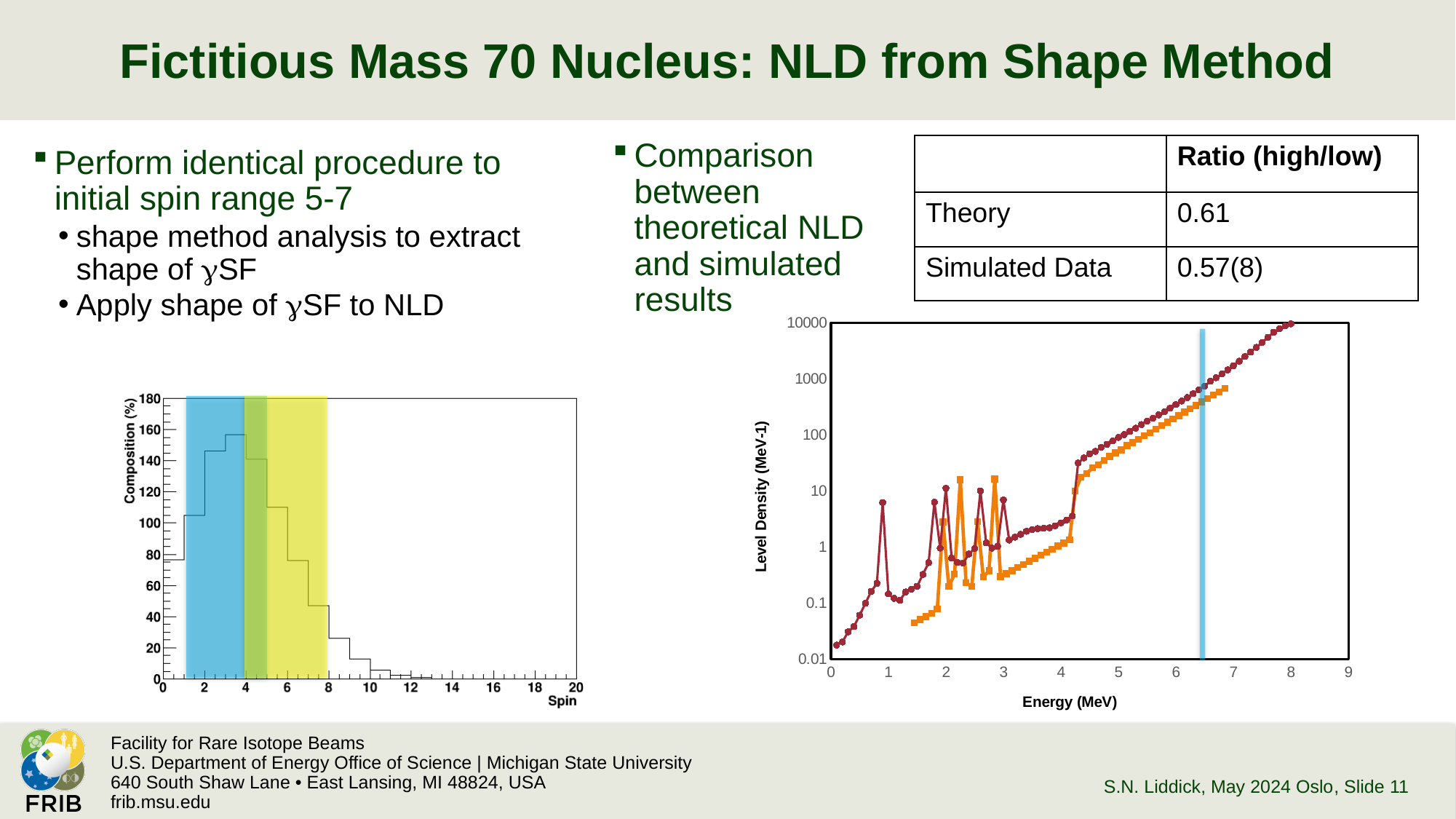
How many data series are plotted in the chart on the right? 2 What is the y-axis label of the chart on the left? Composition (%) What is the highest value shown on the x-axis of the chart on the right? 9 In the chart on the left, is the composition for the spin bin from 9 to 10 greater or less than 40? less What is the x-axis label of the chart on the right? Energy (MeV) In the chart on the left, is the composition for the spin bin from 0 to 1 greater or less than 100? less In the chart on the right, at an energy of 5 MeV, which series has the higher level density: the red circles or the orange squares? red circles In the chart on the right, is the level density of the red-circle series at 8 MeV greater or less than 1000? greater In the chart on the right, does the level density generally rise or fall as energy increases from 4 MeV to 8 MeV? rise What kind of chart is the chart on the right (Level Density vs Energy)? line chart